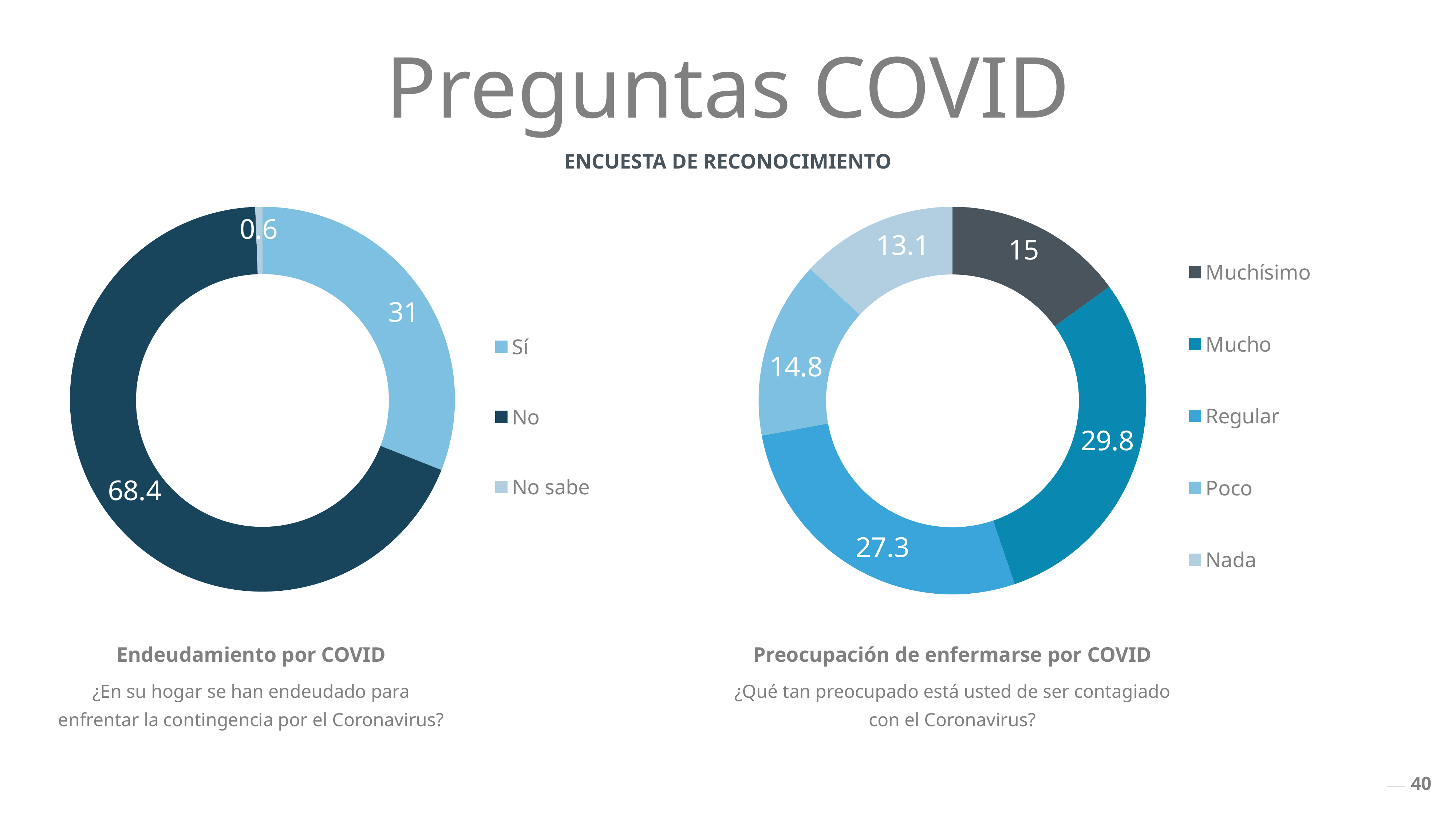
In the 'Endeudamiento por COVID' chart, what is the value for 'Sí'? 31 In the 'Preocupación de enfermarse por COVID' chart, how many categories does the legend list? 5 In the 'Endeudamiento por COVID' chart, which category has the smallest value? No sabe In the 'Endeudamiento por COVID' chart, what is the difference between the values for 'No' and 'Sí'? 37.4 In the 'Preocupación de enfermarse por COVID' chart, what is the difference between the values for 'Mucho' and 'Regular'? 2.5 In the 'Endeudamiento por COVID' chart, how many categories are shown? 3 In the 'Preocupación de enfermarse por COVID' chart, what is the value for 'Nada'? 13.1 In the 'Preocupación de enfermarse por COVID' chart, what is the value for 'Mucho'? 29.8 In the 'Preocupación de enfermarse por COVID' chart, which is larger, 'Poco' or 'Muchísimo'? Muchísimo What type of chart is the 'Endeudamiento por COVID' chart? Doughnut (pie) chart In the 'Preocupación de enfermarse por COVID' chart, which category has the largest value? Mucho In the 'Endeudamiento por COVID' chart, what is the value for 'No'? 68.4